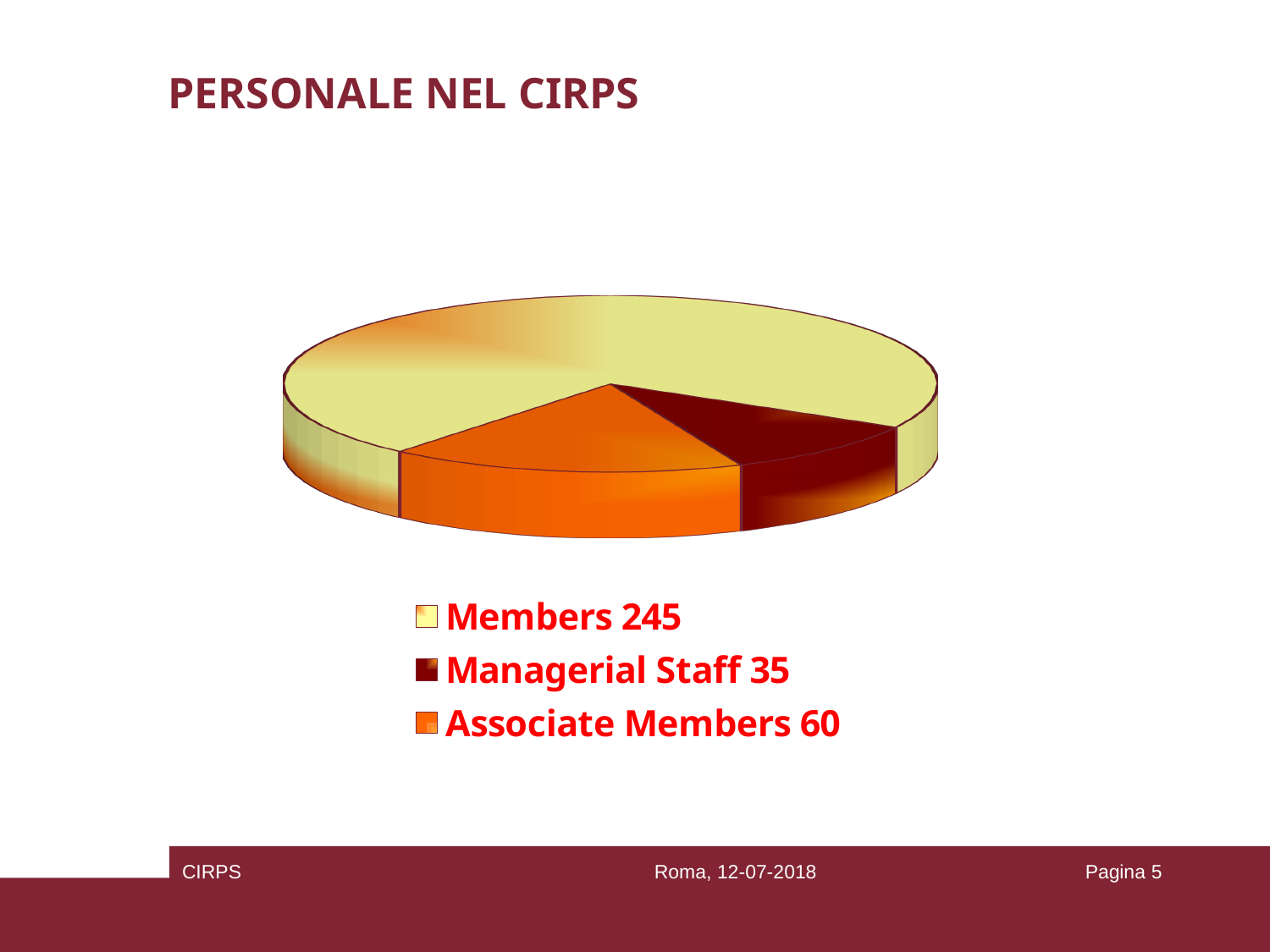
What is the value for Associate Members in the pie chart? 60 What is the difference between the values for Associate Members and Managerial Staff? 25 Which is larger, Associate Members or Managerial Staff? Associate Members What is the total of all the values shown in the pie chart? 340 What is the title of the slide containing the pie chart? PERSONALE NEL CIRPS What kind of chart is shown on the slide? pie chart What is the value for Managerial Staff in the pie chart? 35 Which category has the smallest slice of the pie chart? Managerial Staff How many categories does the pie chart have? 3 What is the value for Members in the pie chart? 245 Which category has the largest slice of the pie chart? Members What is the difference between the values for Members and Associate Members? 185